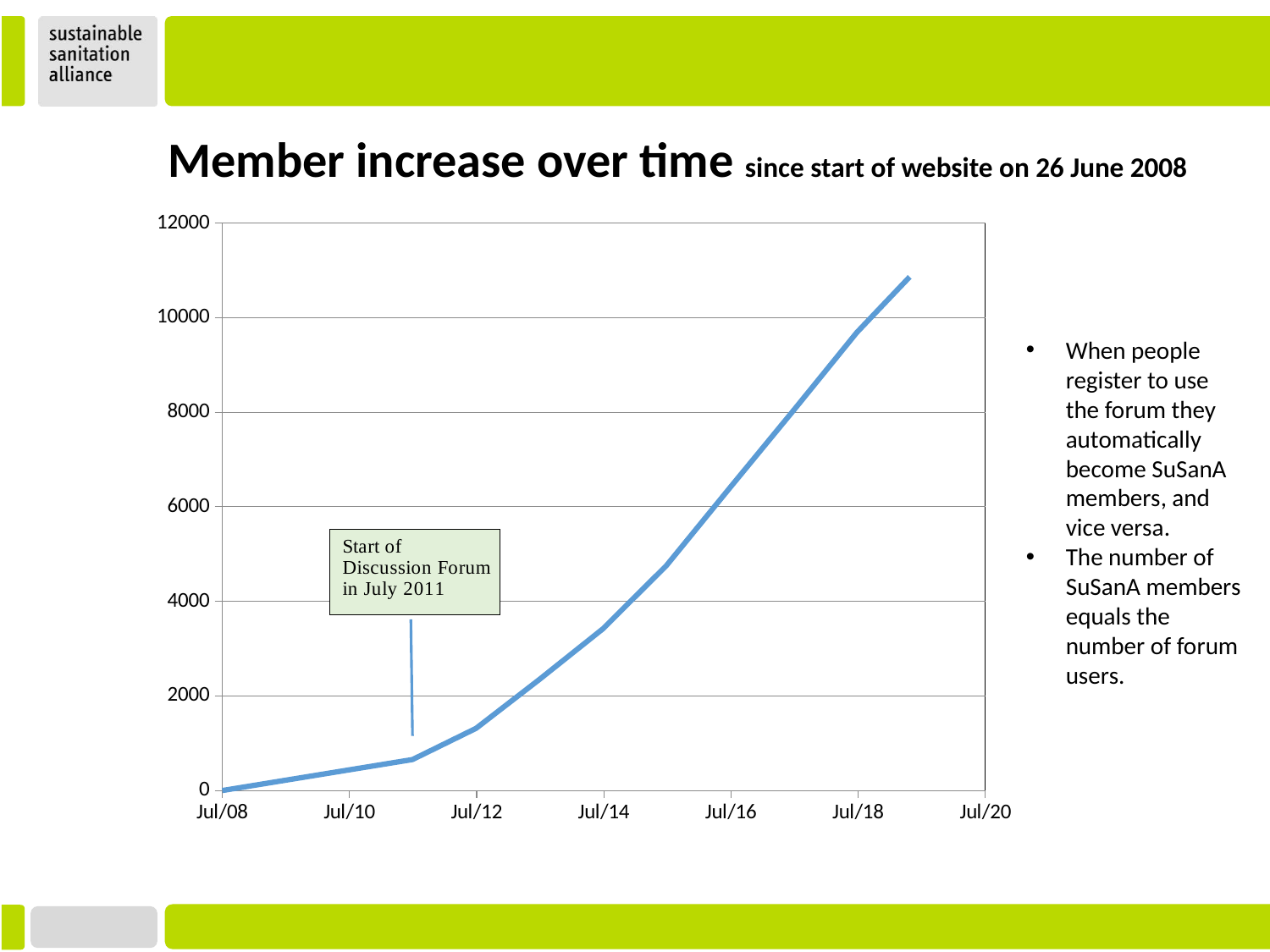
Is the value for Jul/14 greater or less than 2000? greater Is the value for Jul/14 greater or less than 4000? less Is the value for Jul/10 greater or less than 2000? less Do the member numbers rise or fall over time along the x axis? rise What event does the annotation box on the chart mark? Start of Discussion Forum in July 2011 What is the highest value shown on the y axis? 12000 What kind of chart is shown on the slide? line chart How many tick labels are shown on the x axis? 7